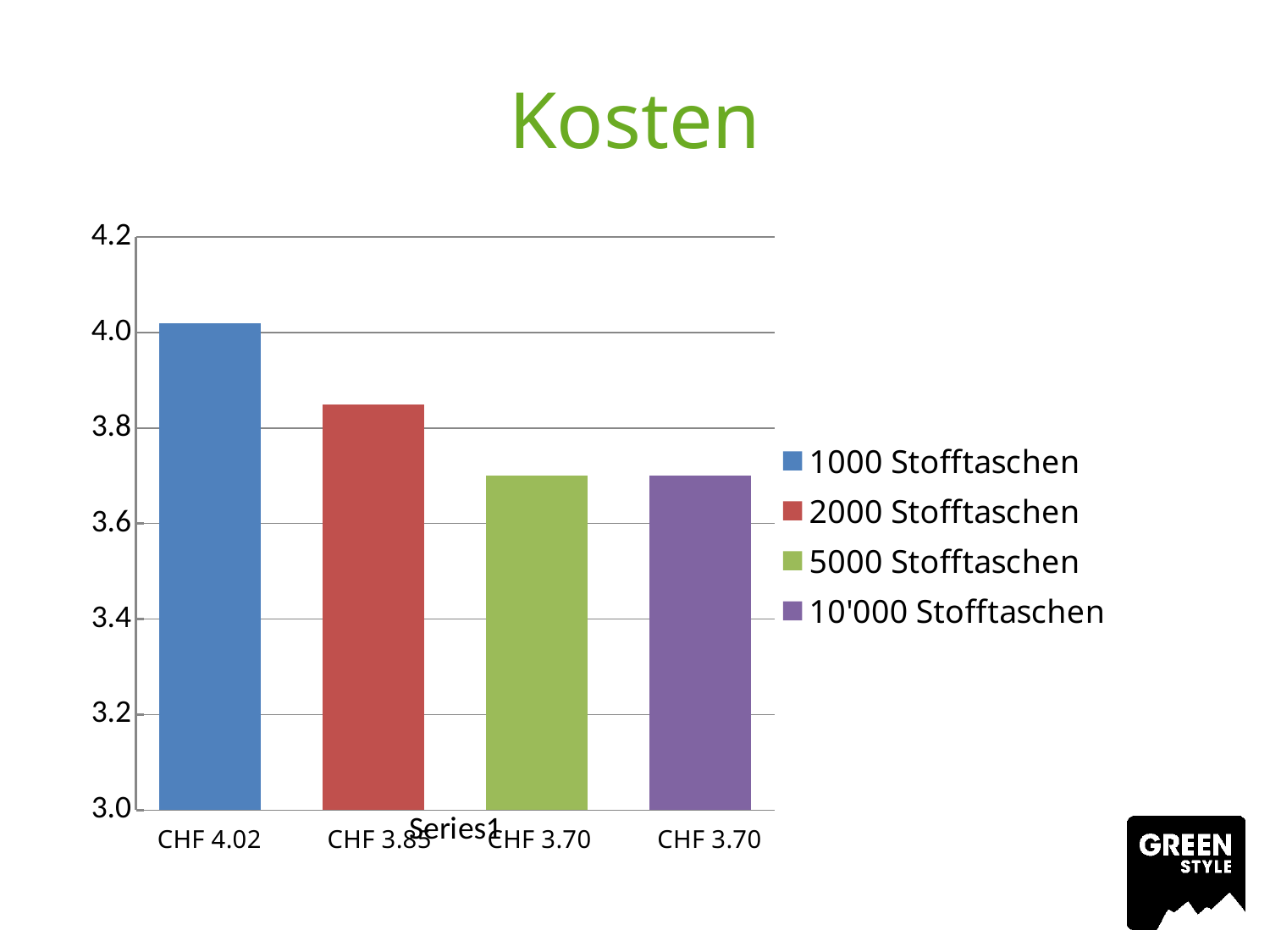
What is the difference between the values for 1000 Stofftaschen and 5000 Stofftaschen? CHF 0.32 What is the value for 1000 Stofftaschen? CHF 4.02 What is the value for 2000 Stofftaschen? CHF 3.85 What is the value for 10'000 Stofftaschen? CHF 3.70 What kind of chart is shown on the slide? bar chart How many bars are plotted in the chart? 4 Which is larger, the value for 1000 Stofftaschen or the value for 2000 Stofftaschen? 1000 Stofftaschen Is the value for 5000 Stofftaschen greater or less than 3.8? less Which category has the highest value? 1000 Stofftaschen How many entries does the legend list? 4 Is the value for 2000 Stofftaschen greater or less than 3.8? greater What is the value for 5000 Stofftaschen? CHF 3.70